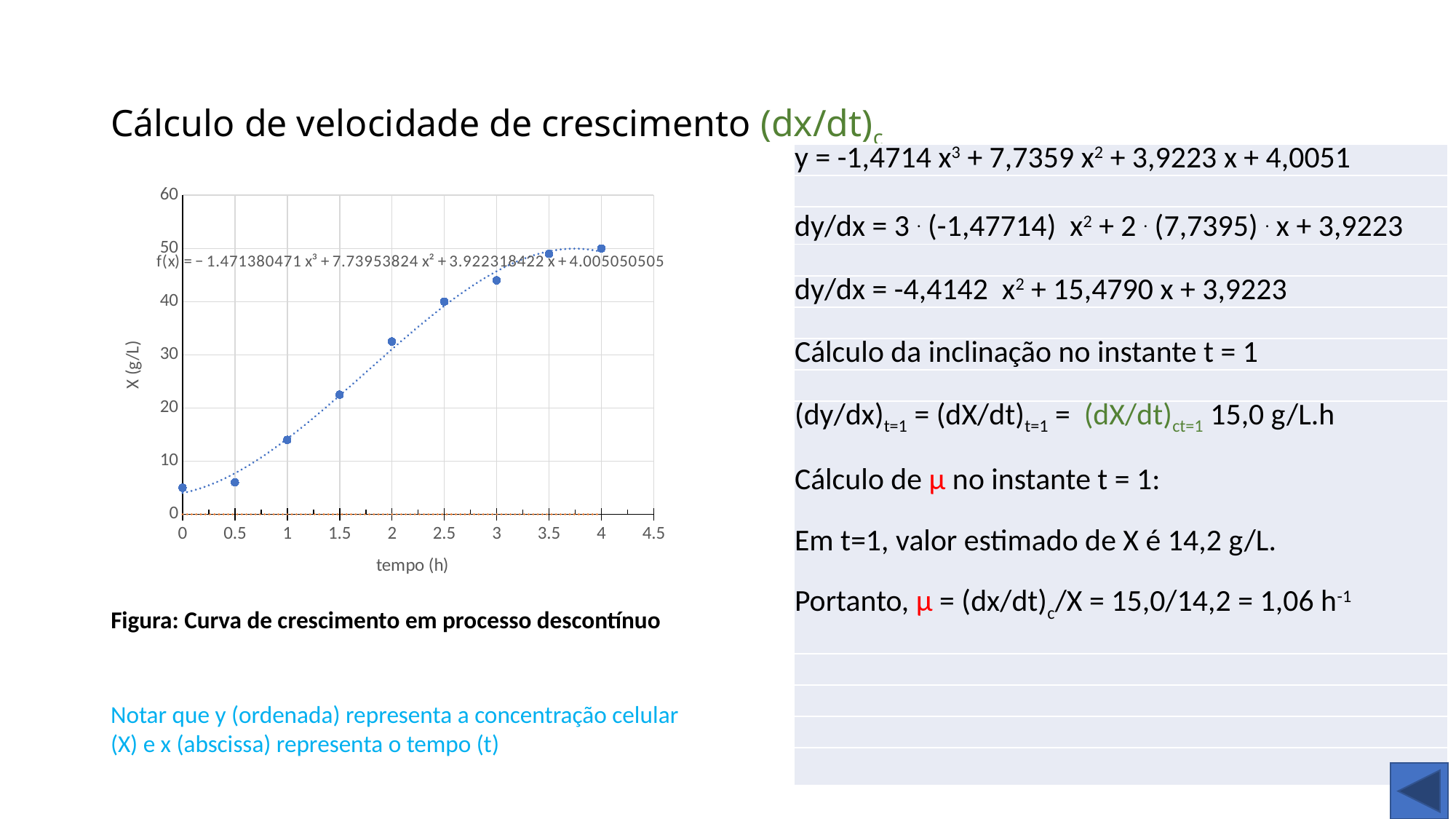
What is the label of the x axis of the chart? tempo (h) Is the value of X at tempo 3 h greater or less than 40? greater How many data points are plotted in the chart? 9 Is the value of X at tempo 1 h greater or less than 10? greater What is the label of the y axis of the chart? X (g/L) Which is larger, the value of X at tempo 3 h or at tempo 1 h? tempo 3 h Is the value of X at tempo 4 h greater or less than 60? less Do the plotted values rise or fall as tempo (h) increases along the x axis? rise What kind of chart is shown on the slide? scatter chart